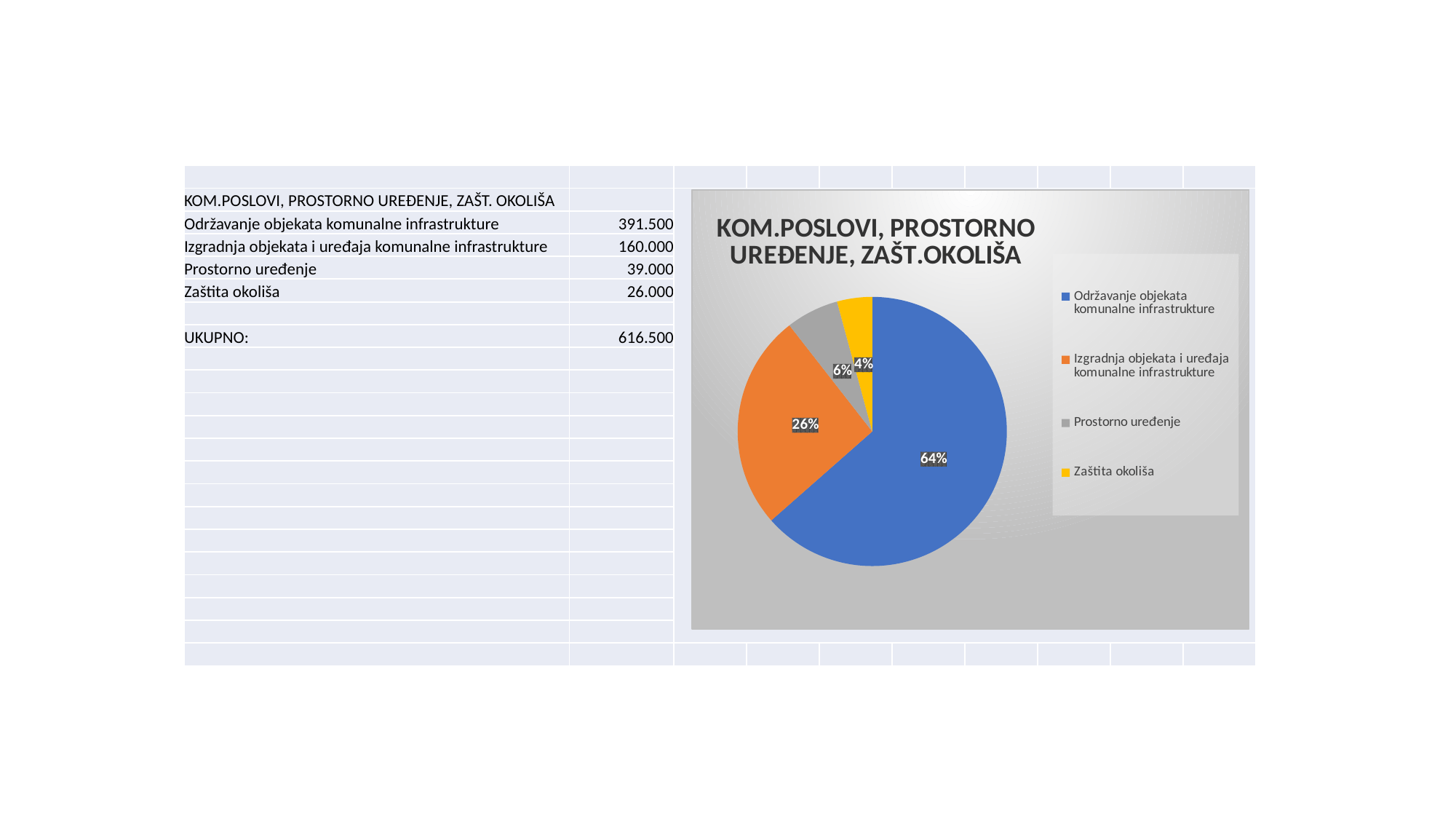
What colour is the Zaštita okoliša slice in the pie chart? yellow Which slice is larger: Prostorno uređenje or Izgradnja objekata i uređaja komunalne infrastrukture? Izgradnja objekata i uređaja komunalne infrastrukture What share of the pie does Prostorno uređenje represent? 6% How many slices does the pie chart have? 4 What is the title of the chart? KOM.POSLOVI, PROSTORNO UREĐENJE, ZAŠT.OKOLIŠA Which category has the largest slice of the pie? Održavanje objekata komunalne infrastrukture What share of the pie does Održavanje objekata komunalne infrastrukture represent? 64% What is the difference in percentage points between the Održavanje objekata komunalne infrastrukture slice and the Izgradnja objekata i uređaja komunalne infrastrukture slice? 38% What share of the pie does Zaštita okoliša represent? 4% Which category has the smallest slice of the pie? Zaštita okoliša What type of chart is shown on the slide? pie chart